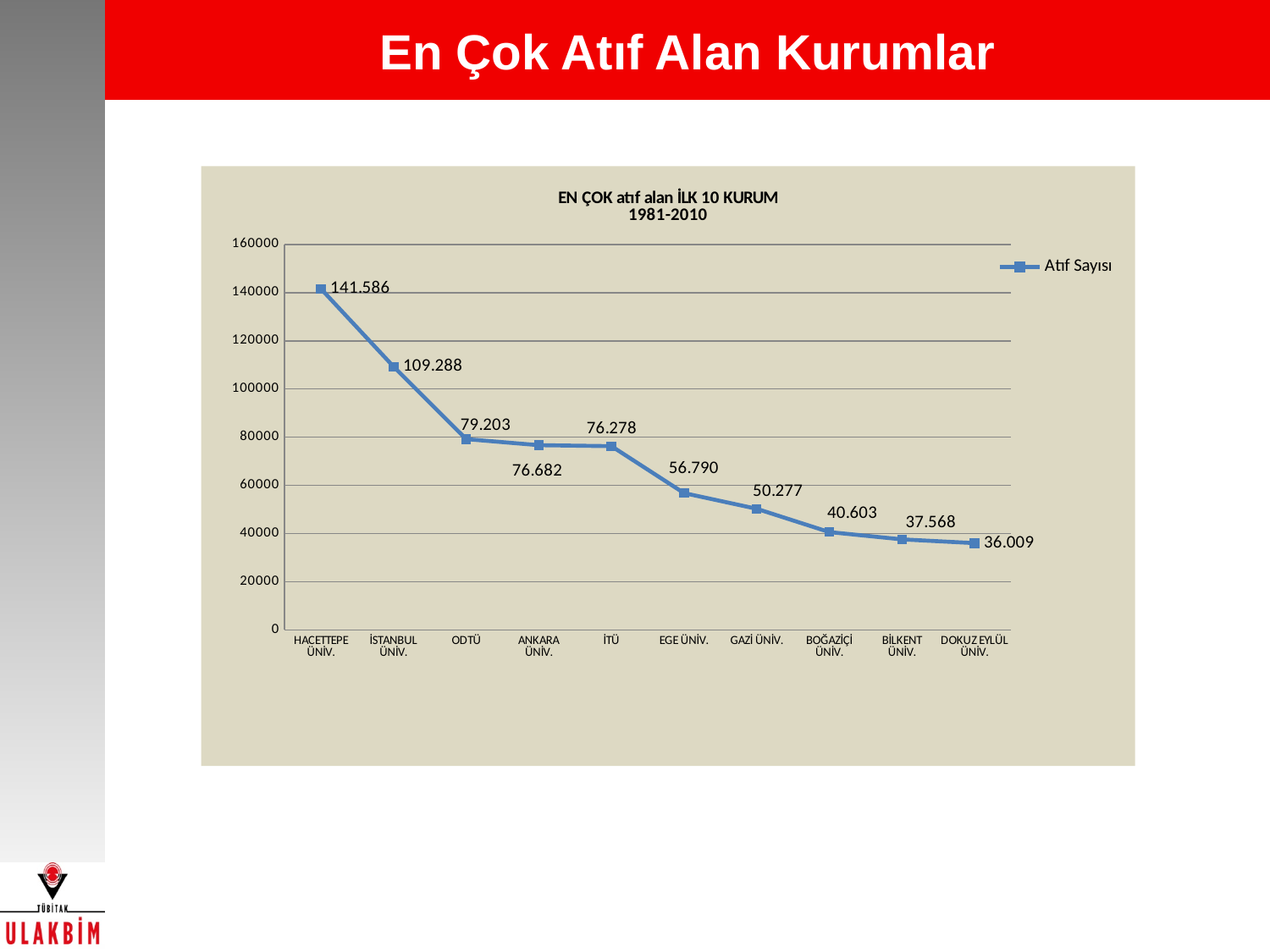
Which has a larger Atıf Sayısı, BOĞAZİÇİ ÜNİV. or BİLKENT ÜNİV.? BOĞAZİÇİ ÜNİV. What is the difference in Atıf Sayısı between HACETTEPE ÜNİV. and İSTANBUL ÜNİV.? 32.298 What is the Atıf Sayısı value for HACETTEPE ÜNİV.? 141.586 What is the Atıf Sayısı value for ODTÜ? 79.203 Which institution has the lowest Atıf Sayısı? DOKUZ EYLÜL ÜNİV. Which institution has the highest Atıf Sayısı? HACETTEPE ÜNİV. How many institutions are shown on the x axis? 10 What is the Atıf Sayısı value for GAZİ ÜNİV.? 50.277 Do the Atıf Sayısı values rise or fall from left to right along the x axis? Fall What is the difference in Atıf Sayısı between EGE ÜNİV. and GAZİ ÜNİV.? 6.513 What kind of chart is shown on the slide? Line chart Is the Atıf Sayısı value for İSTANBUL ÜNİV. greater or less than 100000? greater